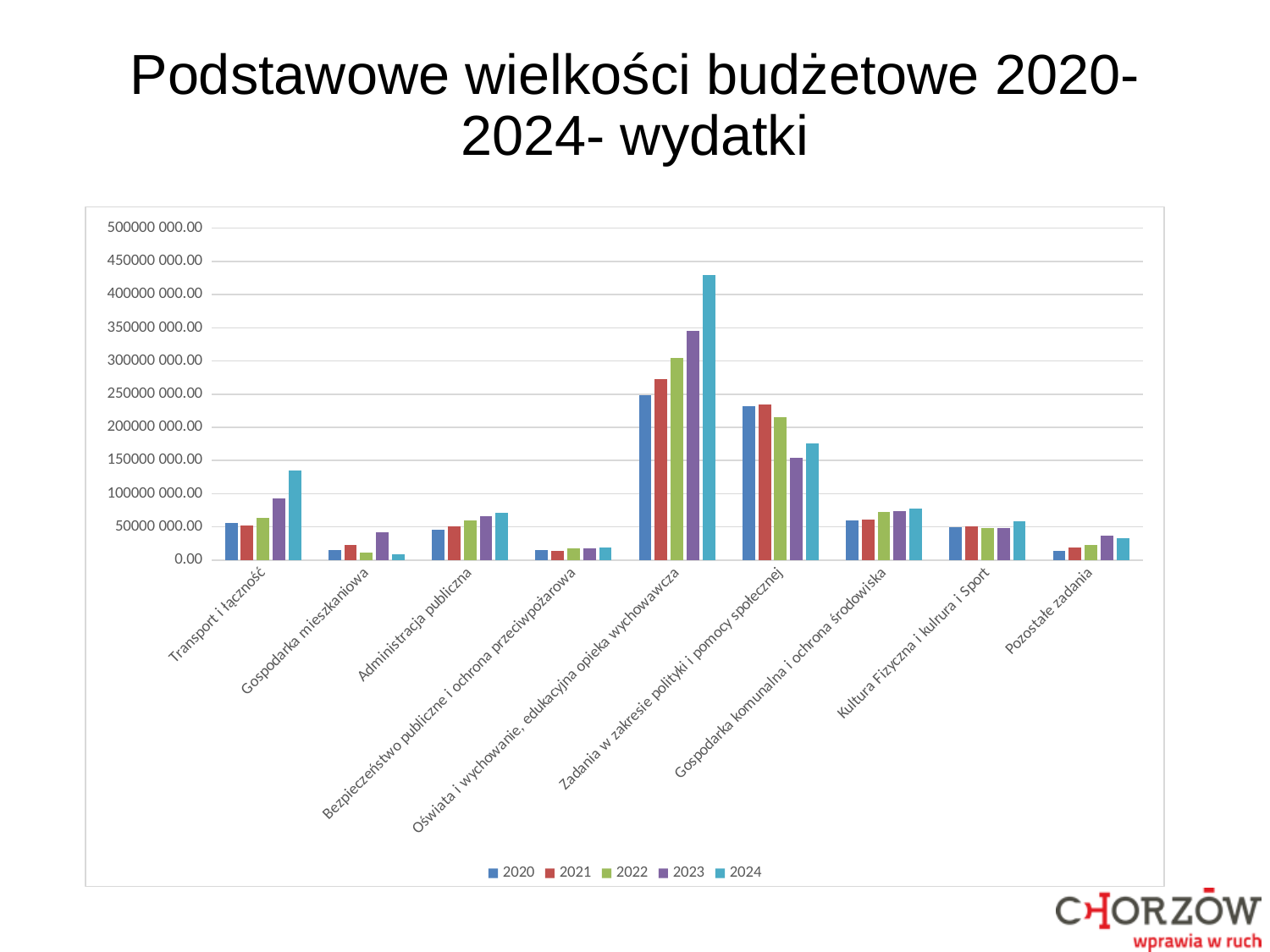
For Oświata i wychowanie, edukacyjna opieka wychowawcza, do the values rise or fall from 2020 to 2024? rise What kind of chart is shown on the slide? Bar chart Is the 2024 value for Transport i łączność greater or less than 100000 000.00? greater Which category has the highest value for 2024? Oświata i wychowanie, edukacyjna opieka wychowawcza Which series are listed in the legend? 2020, 2021, 2022, 2023, 2024 For Transport i łączność, which is larger: the 2020 value or the 2024 value? 2024 How many series does the legend list? 5 Which category has the lowest value for 2024? Gospodarka mieszkaniowa Is the 2024 value for Oświata i wychowanie, edukacyjna opieka wychowawcza greater or less than 400000 000.00? greater Is the 2020 value for Zadania w zakresie polityki i pomocy społecznej greater or less than 200000 000.00? greater How many categories are shown on the x axis? 9